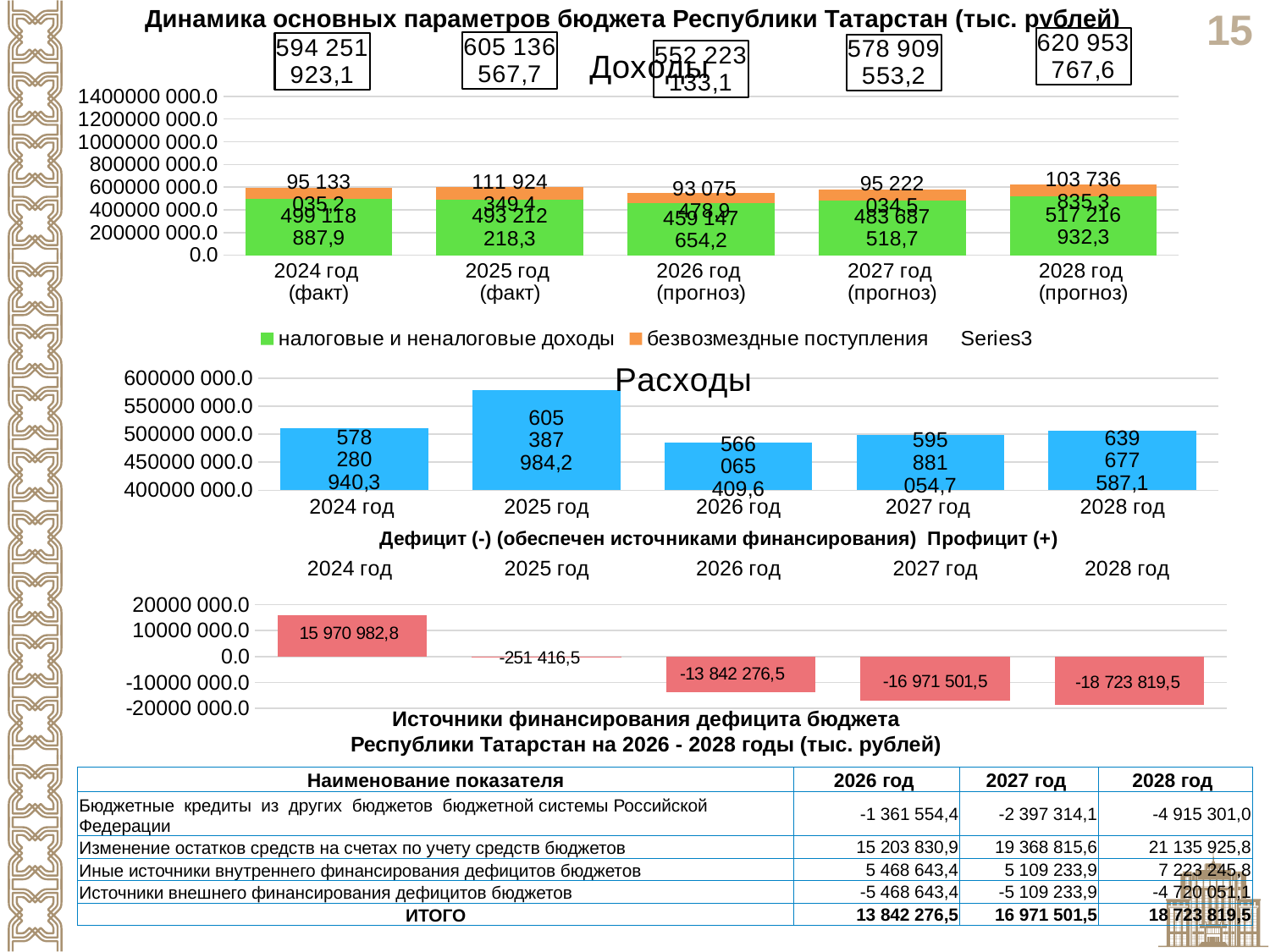
In the Доходы chart, what is the value of налоговые и неналоговые доходы for 2026 год (прогноз)? 459 147 654,2 In the Доходы chart, which year has the highest value of безвозмездные поступления? 2025 год (факт) In the Расходы chart, which is larger: the value for 2025 год or for 2027 год? 2025 год In the Дефицит (-) / Профицит (+) chart, what is the value for 2027 год? -16 971 501,5 In the Доходы chart, what is the value of безвозмездные поступления for 2028 год (прогноз)? 103 736 835,3 In the Расходы chart, what is the difference between the values for 2028 год and 2024 год? 61 396 646,8 In the Доходы chart, what is the total of the stacked bar for 2024 год (факт)? 594 251 923,1 In the Расходы chart, which year has the lowest value? 2026 год How many series does the legend of the Доходы chart list? 3 In the Расходы chart, what is the value for 2025 год? 605 387 984,2 In the Дефицит (-) / Профицит (+) chart, do the values rise or fall from 2024 год to 2028 год? fall